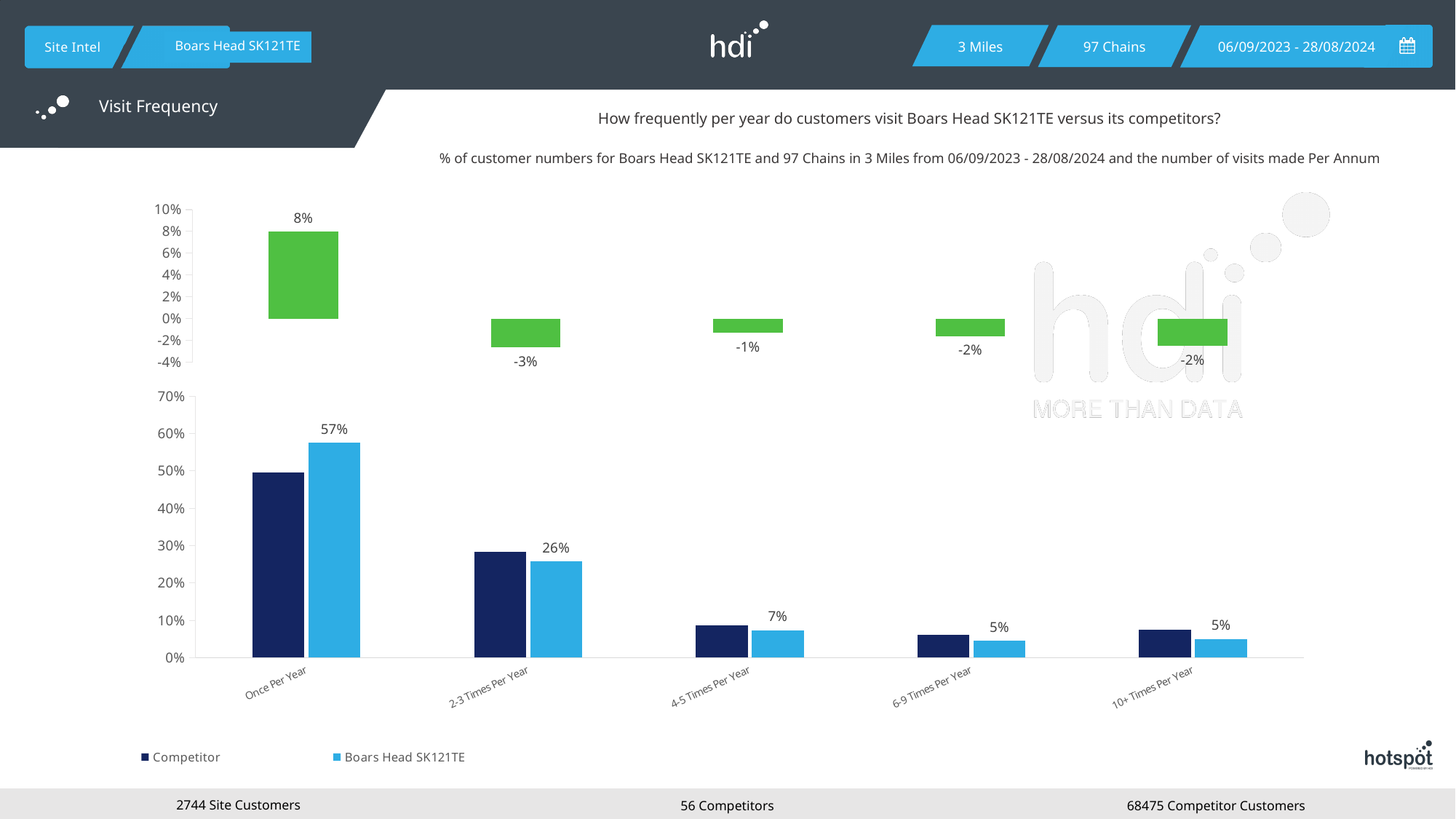
In the bottom chart, is the Competitor value for Once Per Year greater or less than 40%? greater How many series does the legend of the bottom chart list? 2 In the top chart, what is the difference value shown for Once Per Year? 8% In the bottom chart, what is the Boars Head SK121TE value for 2-3 Times Per Year? 26% In the bottom chart, what percentage of Boars Head SK121TE customers visit Once Per Year? 57% In the bottom chart, which visit frequency category has the highest Boars Head SK121TE value? Once Per Year In the bottom chart, what is the Boars Head SK121TE value for 4-5 Times Per Year? 7% In the top chart, what is the value shown for 2-3 Times Per Year? -3% In the bottom chart, what is the difference between the Boars Head SK121TE values for Once Per Year and 2-3 Times Per Year? 31% In the top chart, which visit frequency category has the lowest value? 2-3 Times Per Year How many visit frequency categories are shown on the x axis of the bottom chart? 5 In the bottom chart, which is larger for Once Per Year: the Competitor bar or the Boars Head SK121TE bar? Boars Head SK121TE